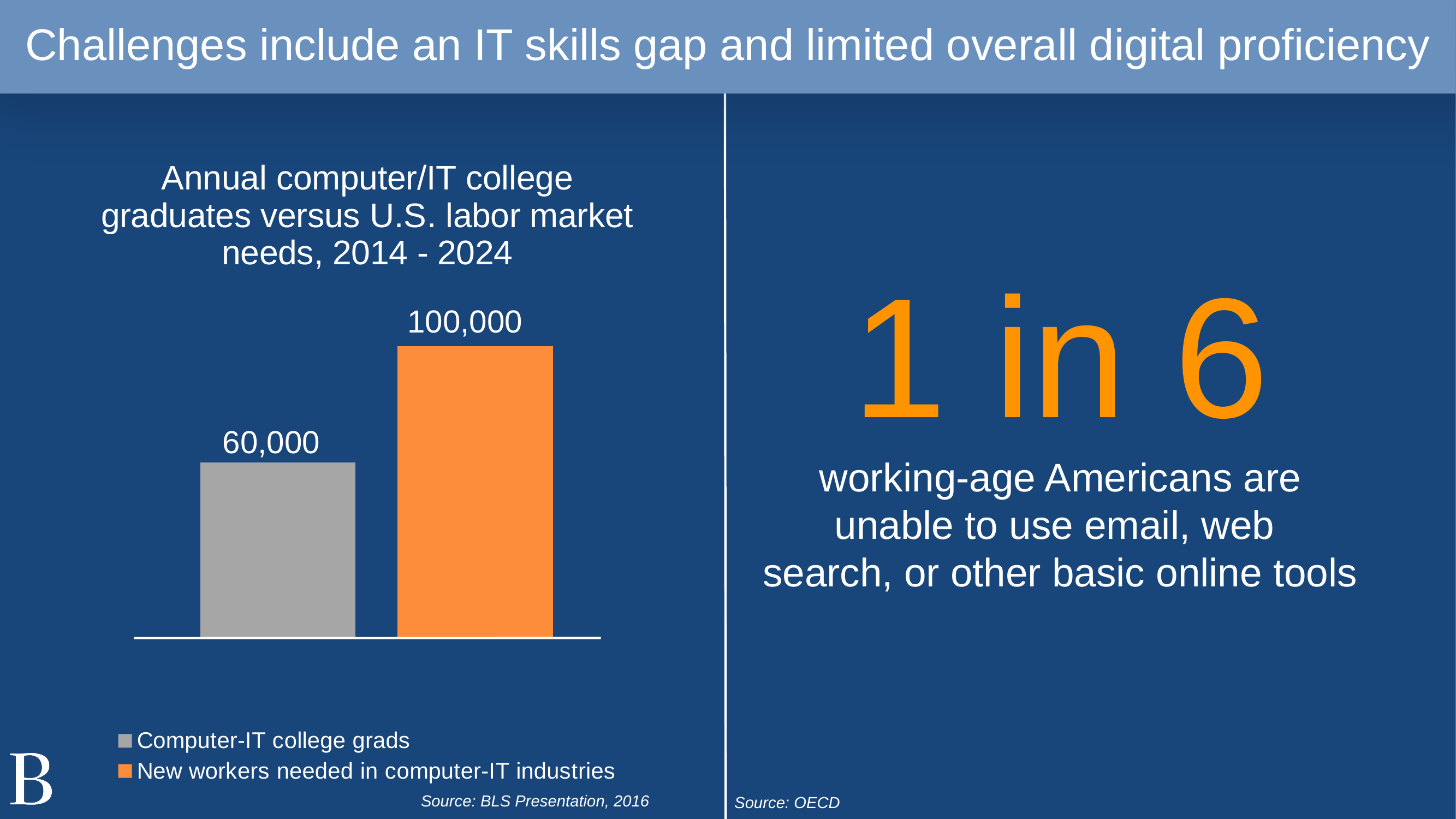
What is the title of the chart? Annual computer/IT college graduates versus U.S. labor market needs, 2014 - 2024 What kind of chart is shown on the slide? bar chart What is the difference between New workers needed in computer-IT industries and Computer-IT college grads? 40,000 Which series has the higher value, Computer-IT college grads or New workers needed in computer-IT industries? New workers needed in computer-IT industries What colour is the bar for New workers needed in computer-IT industries? orange What is the value for Computer-IT college grads? 60,000 Which series has the lower value? Computer-IT college grads What is the value for New workers needed in computer-IT industries? 100,000 How many bars are plotted in the chart? 2 Is the value for Computer-IT college grads larger or smaller than the value for New workers needed in computer-IT industries? smaller How many series does the legend list? 2